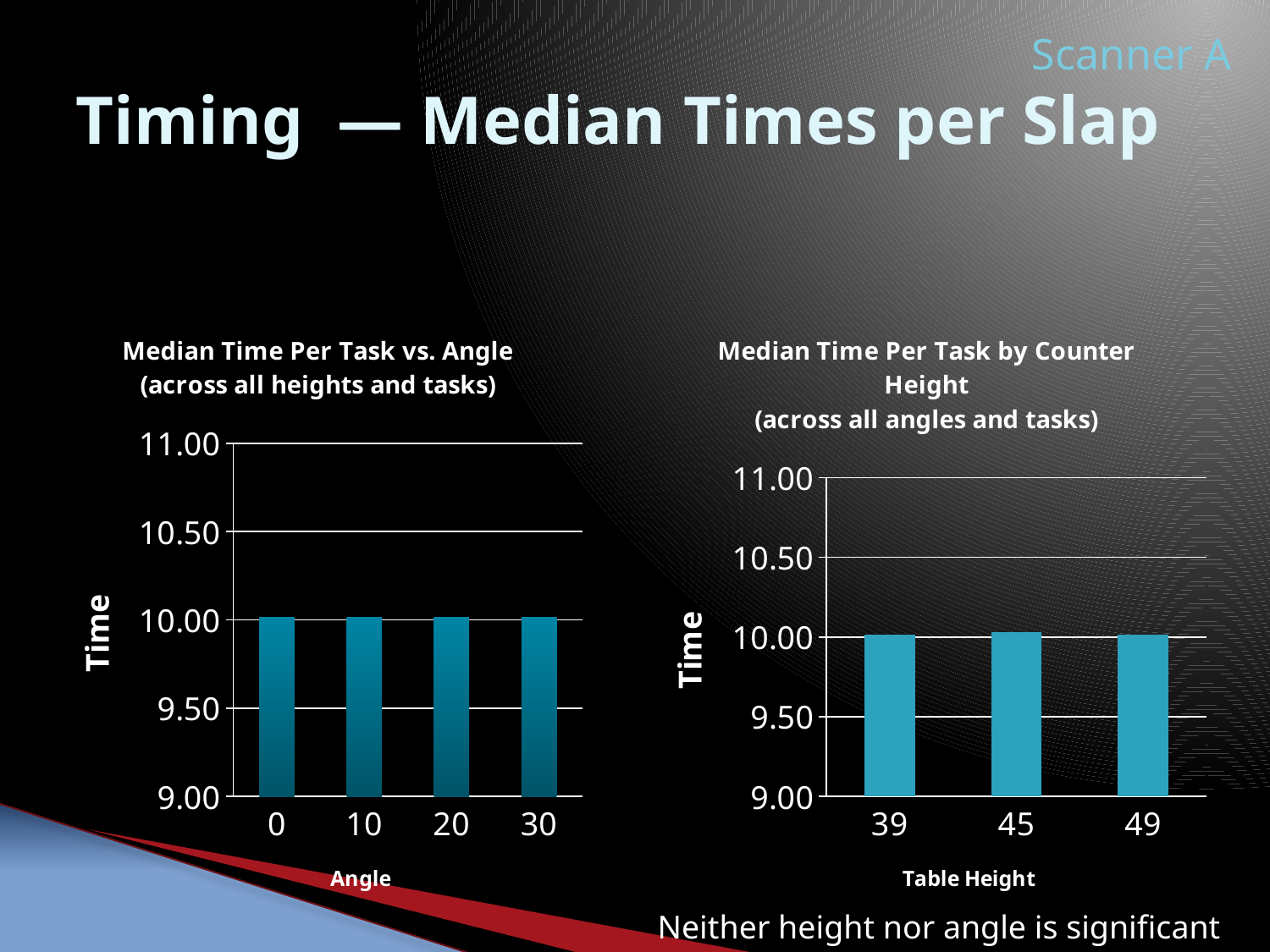
What kind of chart is the left chart, 'Median Time Per Task vs. Angle'? bar chart In the right chart, 'Median Time Per Task by Counter Height', how many table height categories are plotted? 3 In the left chart, 'Median Time Per Task vs. Angle', is the value for angle 0 greater or less than 9.50? greater In the left chart, 'Median Time Per Task vs. Angle', what are the angle categories shown on the x axis? 0, 10, 20, 30 In the right chart, 'Median Time Per Task by Counter Height', what are the table height categories shown on the x axis? 39, 45, 49 In the left chart, 'Median Time Per Task vs. Angle', is the value for angle 20 greater or less than 10.50? less What kind of chart is the right chart, 'Median Time Per Task by Counter Height'? bar chart In the right chart, 'Median Time Per Task by Counter Height', is the value for table height 39 greater or less than 9.50? greater What is the x-axis label of the right chart, 'Median Time Per Task by Counter Height'? Table Height What is the x-axis label of the left chart, 'Median Time Per Task vs. Angle'? Angle